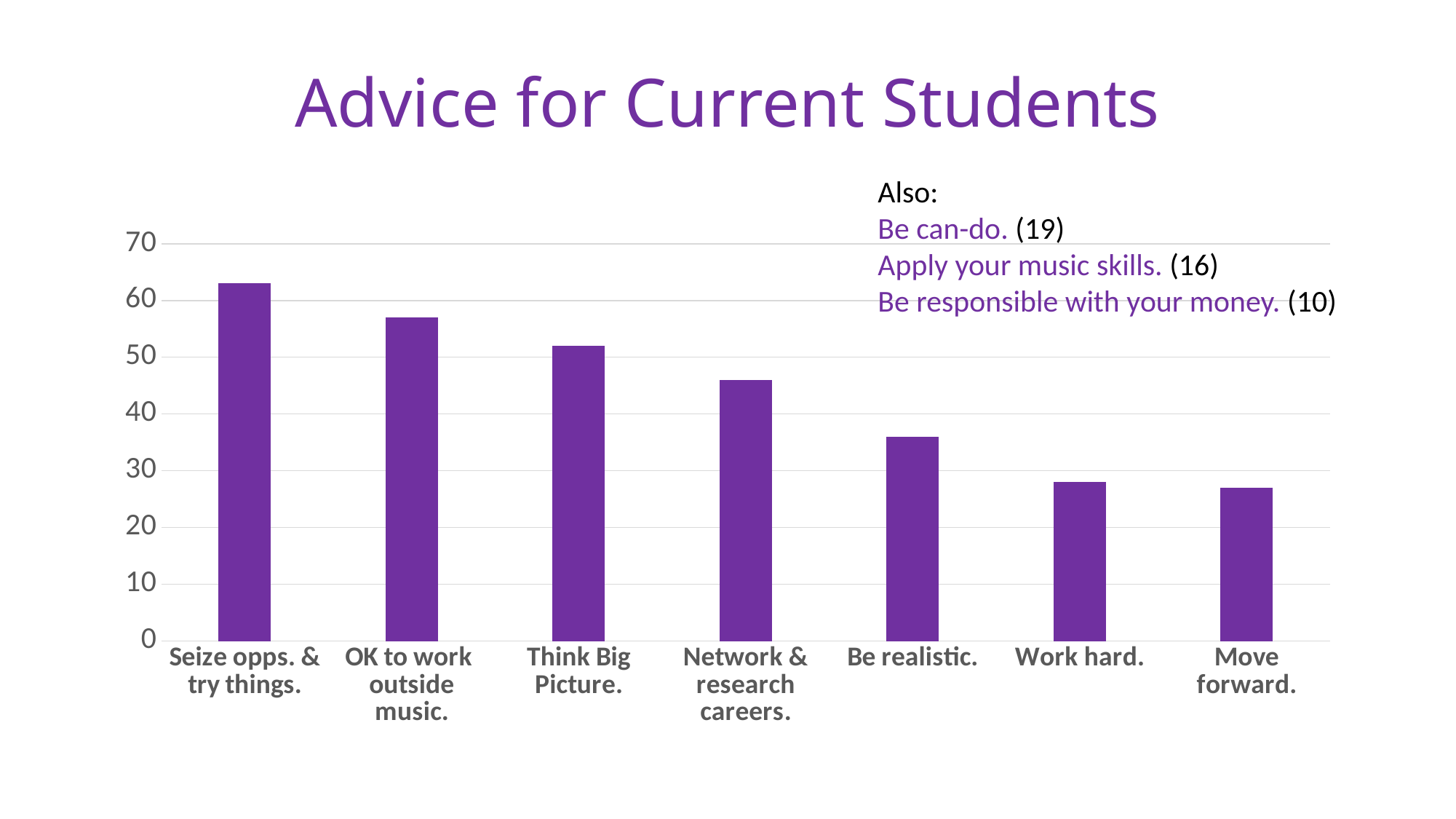
Do the bar values rise or fall from left to right along the x axis? fall Is the value for "Think Big Picture." greater or less than 60? less Is the value for "OK to work outside music." greater or less than 50? greater Which is larger, the value for "Think Big Picture." or the value for "Be realistic."? Think Big Picture. What is the title of the slide containing the chart? Advice for Current Students How many categories are plotted on the chart? 7 What kind of chart is shown on the slide? bar chart Is the value for "Be realistic." greater or less than 40? less Which category has the highest bar? Seize opps. & try things.